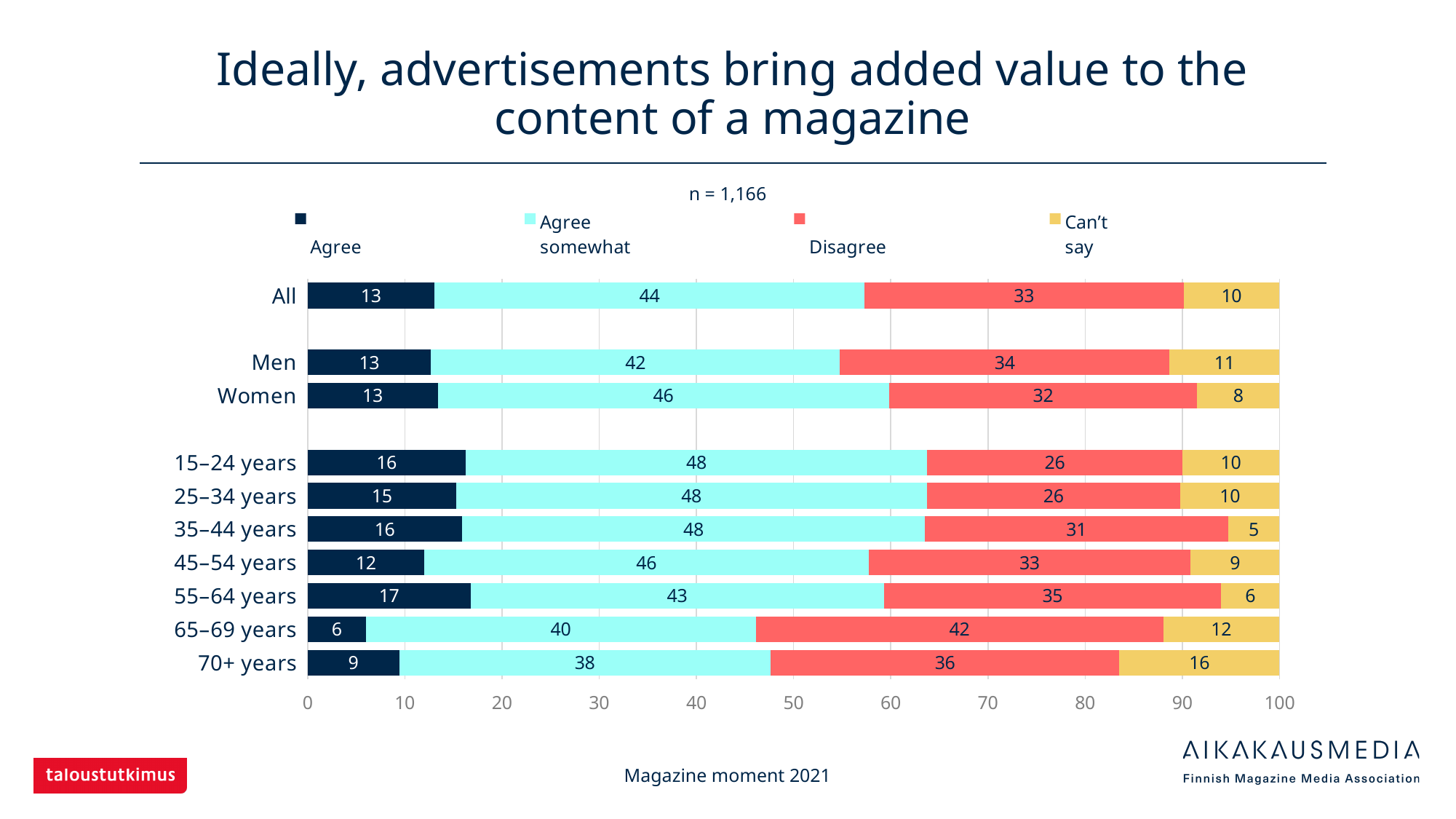
What is the difference between the 'Disagree' values for Men and Women? 2 Which is larger, the 'Agree somewhat' value for Men or for Women? Women What is the 'Agree somewhat' value for the 'All' category? 44 What is the 'Can't say' value for the 70+ years group? 16 What is the total of the stacked bar for the 15–24 years group? 100 Which category has the lowest 'Can't say' value? 35–44 years What sample size (n) is shown on the slide? n = 1,166 How many series does the legend list? 4 What is the 'Disagree' value for the 65–69 years group? 42 What kind of chart is shown on the slide? Stacked bar chart Which category has the lowest 'Agree' value? 65–69 years Which category has the highest 'Agree' value? 55–64 years